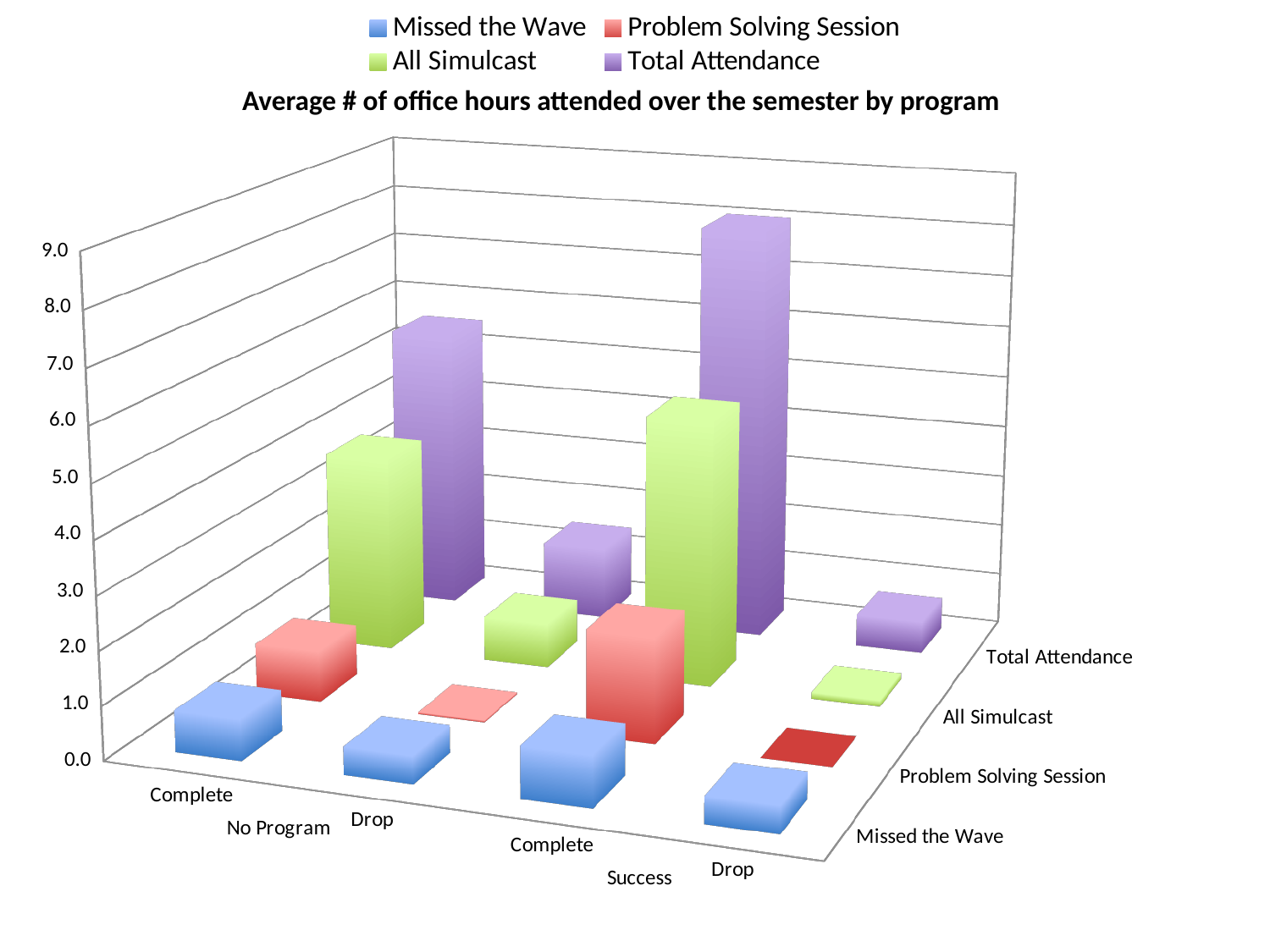
Is the Total Attendance value for Success Drop greater or less than 2.0? less How many series does the legend list? 4 Which series has the highest value for the Success Complete category? Total Attendance Which series is shown in purple in the legend? Total Attendance Which is larger, the Total Attendance value for Success Complete or for No Program Complete? Success Complete What kind of chart is shown on the slide? bar chart What is the title of the chart? Average # of office hours attended over the semester by program Is the Total Attendance value for Success Complete greater or less than 5.0? greater Is the All Simulcast value for No Program Complete greater or less than 3.0? greater Which category has the highest Total Attendance value? Success Complete Which is larger, the All Simulcast value for Success Complete or for Success Drop? Success Complete